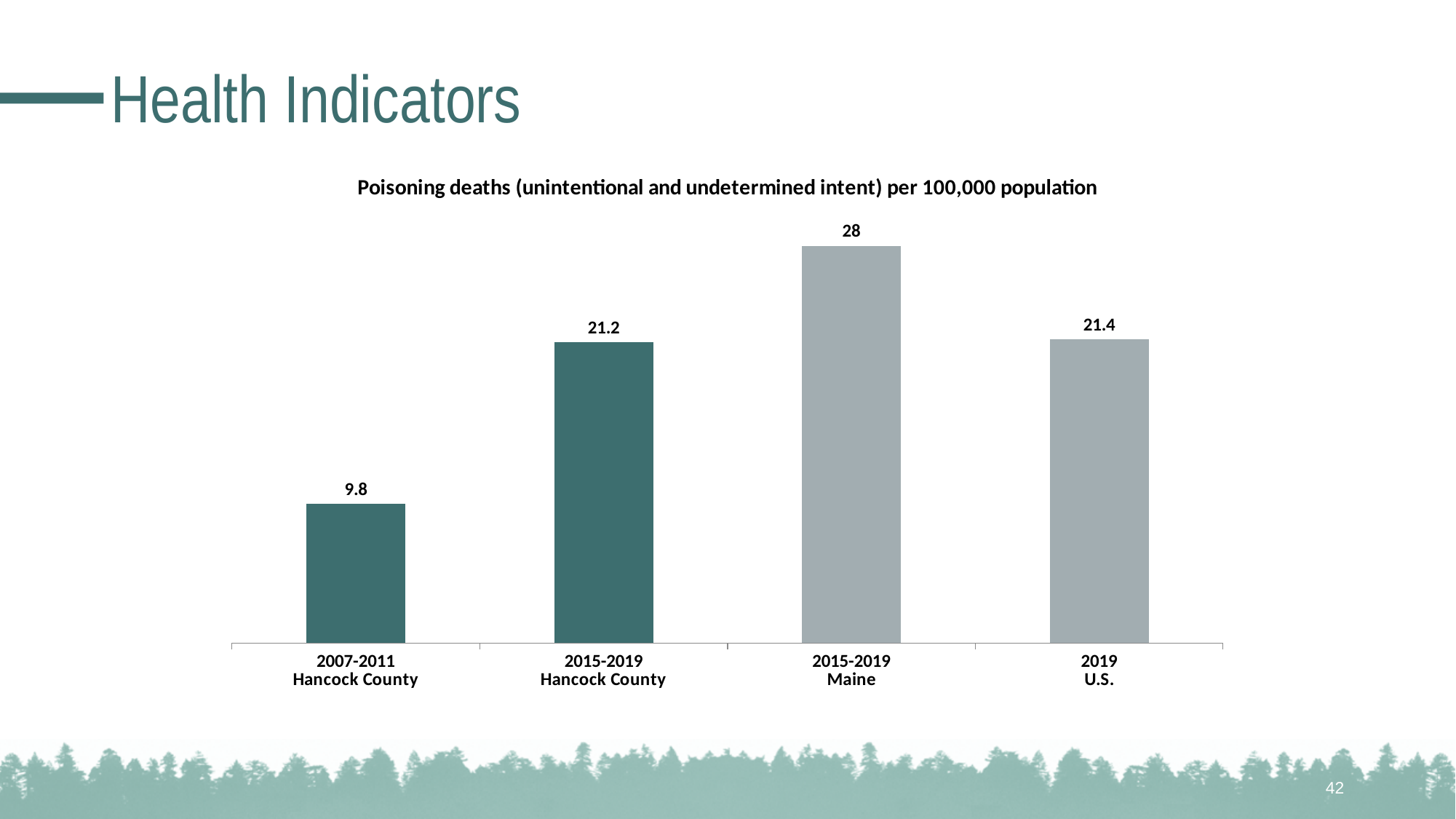
What is the poisoning death rate per 100,000 population for Hancock County in 2007-2011? 9.8 What is the difference between the Maine 2015-2019 rate and the Hancock County 2015-2019 rate? 6.8 Which category has the highest poisoning death rate? 2015-2019 Maine What is the poisoning death rate per 100,000 population for the U.S. in 2019? 21.4 Which category has the lowest poisoning death rate? 2007-2011 Hancock County By how much did the Hancock County poisoning death rate increase from 2007-2011 to 2015-2019? 11.4 What is the poisoning death rate per 100,000 population for Hancock County in 2015-2019? 21.2 What is the poisoning death rate per 100,000 population for Maine in 2015-2019? 28 What is the title of the chart? Poisoning deaths (unintentional and undetermined intent) per 100,000 population Which is larger, the Hancock County 2015-2019 rate or the Maine 2015-2019 rate? Maine 2015-2019 What type of chart is shown on the slide? Bar chart How many bars are shown in the chart? 4